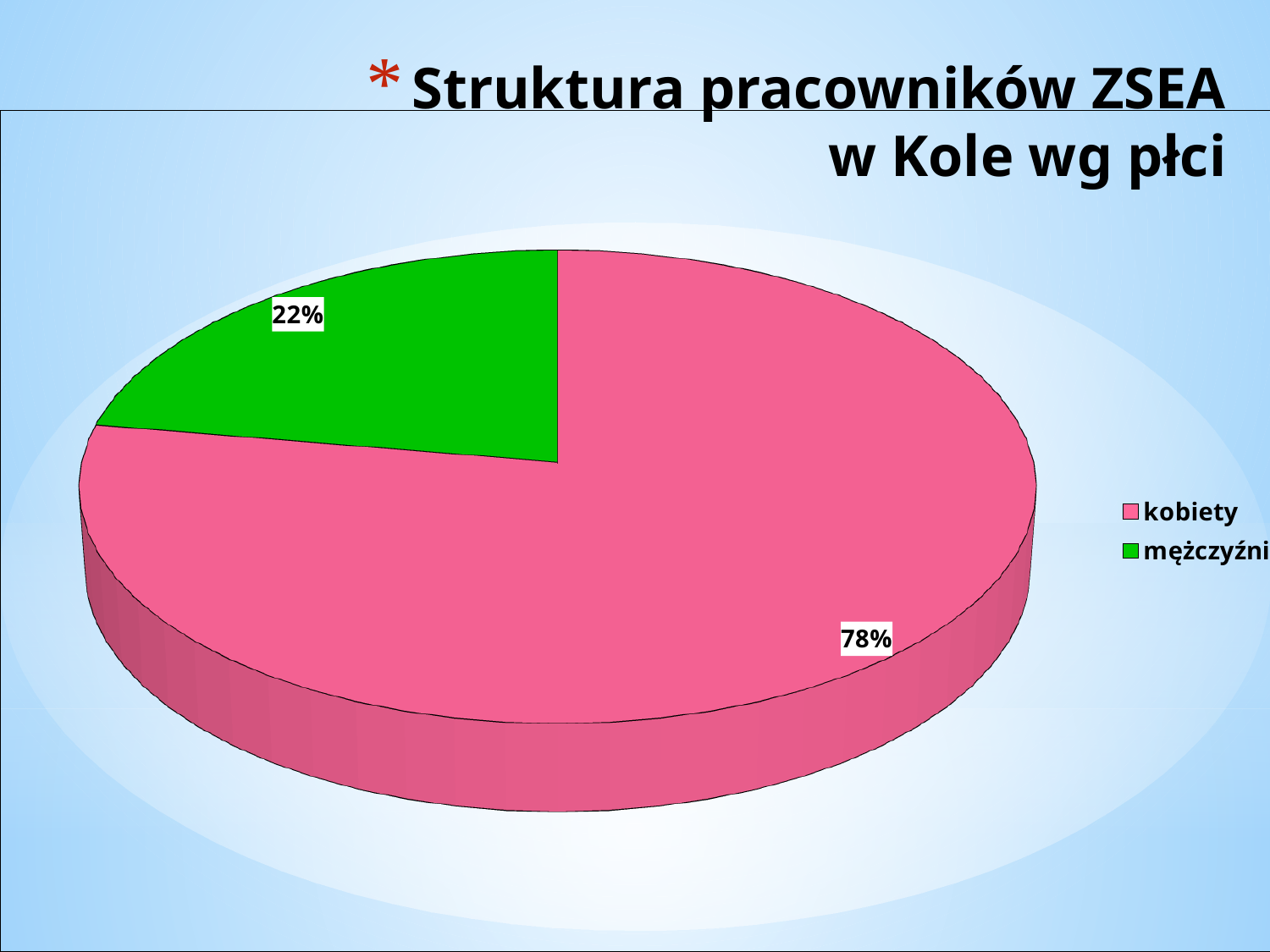
What is the title of the slide? Struktura pracowników ZSEA w Kole wg płci What colour is the 'mężczyźni' slice? green Which category has the largest slice of the pie? kobiety Which slice is larger, 'kobiety' or 'mężczyźni'? kobiety What is the difference in percentage points between the 'kobiety' and 'mężczyźni' slices? 56 What share of the pie does the 'mężczyźni' slice represent? 22% How many entries does the legend list? 2 What kind of chart is shown on the slide? pie chart How many categories are shown in the pie chart? 2 What share of the pie does the 'kobiety' slice represent? 78% Which category has the smallest slice of the pie? mężczyźni